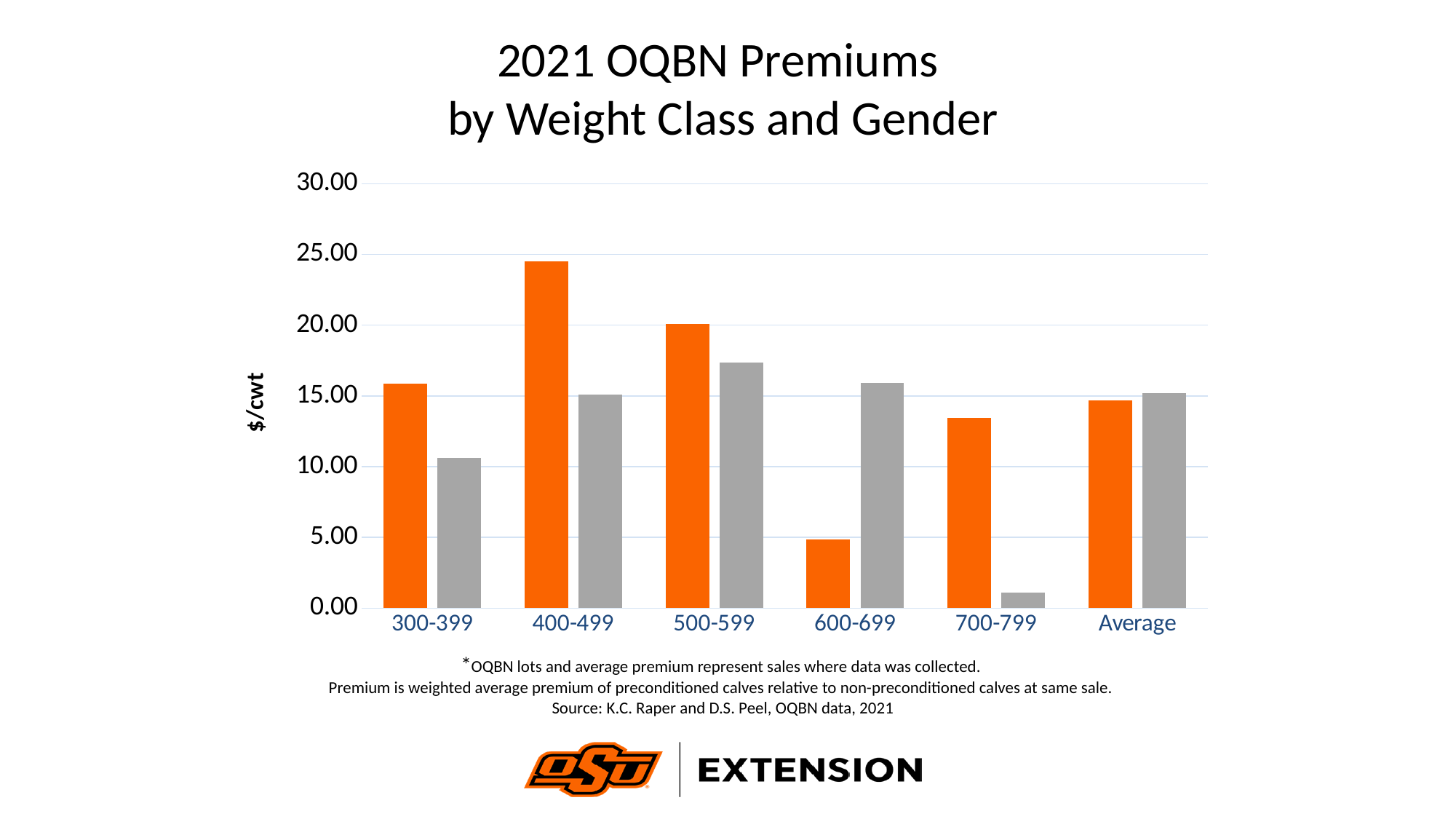
Is the orange bar for 400-499 greater or less than 20.00? greater What is the label on the vertical axis? $/cwt How many categories are shown along the x axis? 6 Which category has the shortest orange bar? 600-699 Which category has the shortest gray bar? 700-799 For the 300-399 category, which bar is taller, the orange bar or the gray bar? orange bar For the 600-699 category, which bar is taller, the orange bar or the gray bar? gray bar Is the gray bar for 700-799 greater or less than 5.00? less What kind of chart is shown on the slide? bar chart Which category has the tallest gray bar? 500-599 Which category has the tallest orange bar? 400-499 Is the orange bar for 600-699 greater or less than 10.00? less